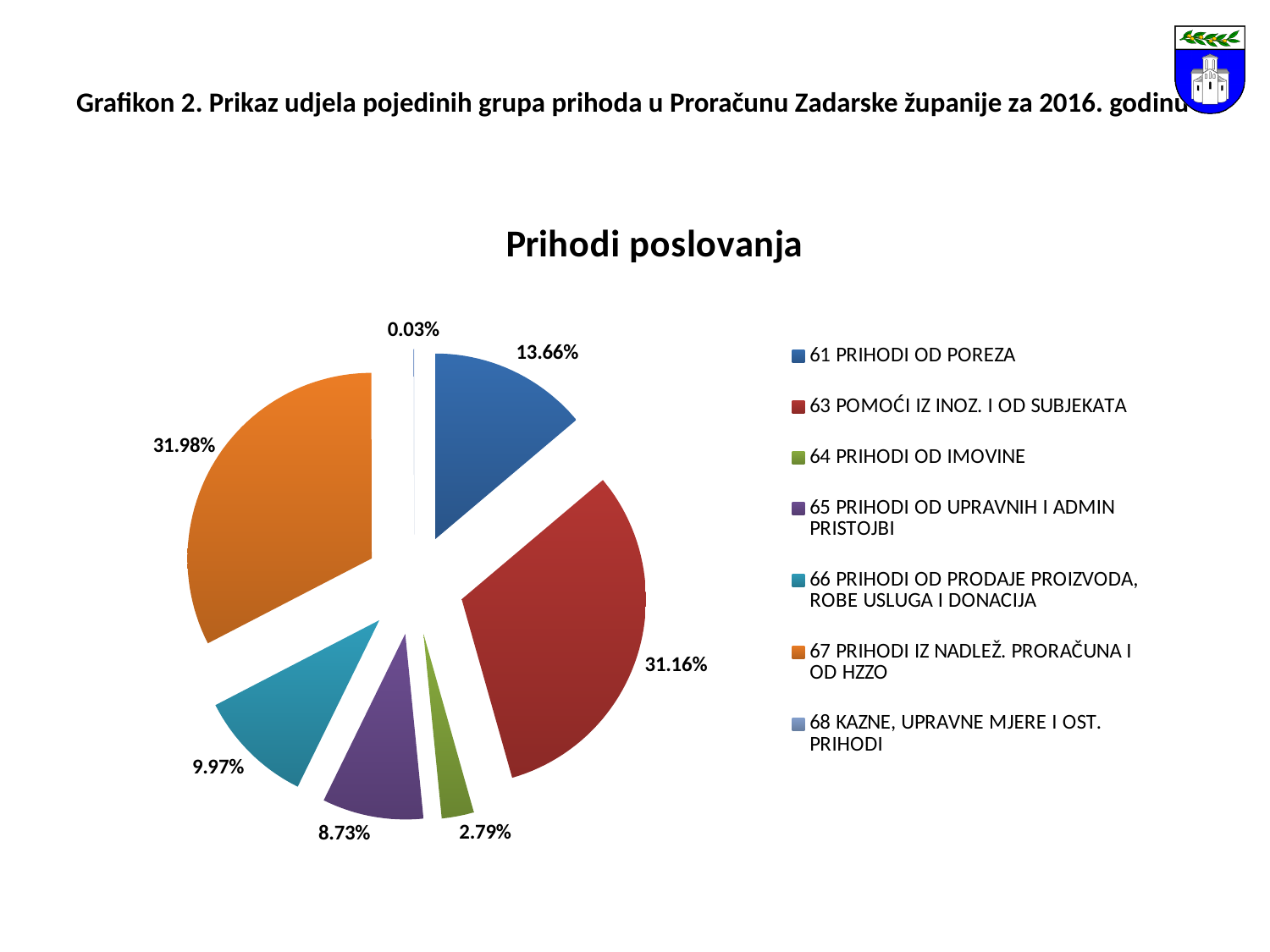
What share of the pie does 64 PRIHODI OD IMOVINE have? 2.79% What share of the pie does 61 PRIHODI OD POREZA have? 13.66% Which category has the smallest share of the pie? 68 KAZNE, UPRAVNE MJERE I OST. PRIHODI What is the difference in share between 67 PRIHODI IZ NADLEŽ. PRORAČUNA I OD HZZO and 63 POMOĆI IZ INOZ. I OD SUBJEKATA? 0.82% What share of the pie does 63 POMOĆI IZ INOZ. I OD SUBJEKATA have? 31.16% Which category has the largest share of the pie? 67 PRIHODI IZ NADLEŽ. PRORAČUNA I OD HZZO How many slices does the pie chart have? 7 Which has a larger share: 65 PRIHODI OD UPRAVNIH I ADMIN PRISTOJBI or 66 PRIHODI OD PRODAJE PROIZVODA, ROBE USLUGA I DONACIJA? 66 PRIHODI OD PRODAJE PROIZVODA, ROBE USLUGA I DONACIJA What type of chart is shown on the slide? pie chart What is the chart's title? Prihodi poslovanja